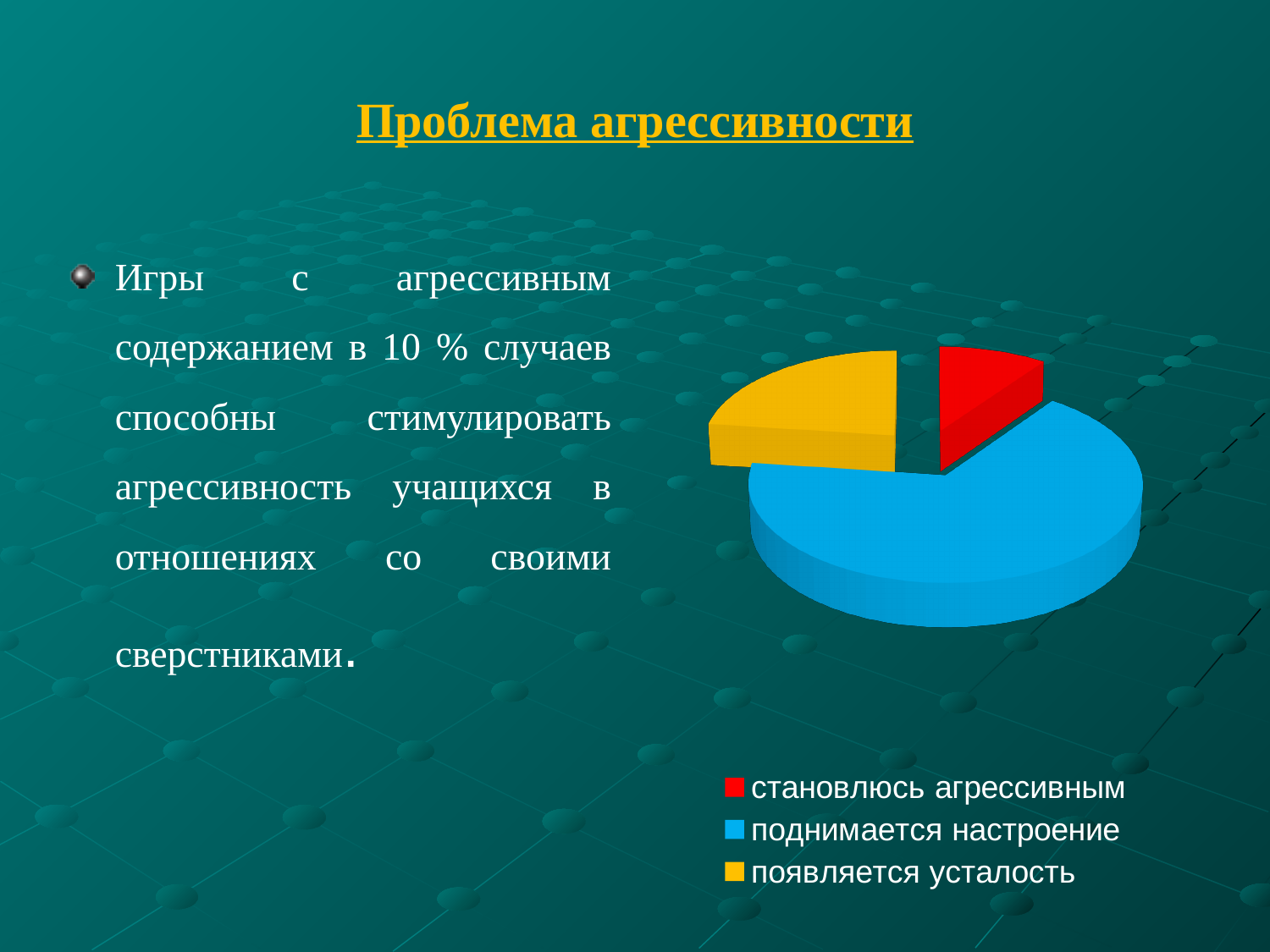
What colour is the slice for "появляется усталость" in the pie chart? yellow Which category has the smallest slice in the pie chart? становлюсь агрессивным How many slices does the pie chart have? 3 Which category is shown in red in the pie chart? становлюсь агрессивным Which slice is larger: "поднимается настроение" or "появляется усталость"? поднимается настроение How many entries does the legend of the pie chart list? 3 Which slice is larger: "появляется усталость" or "становлюсь агрессивным"? появляется усталость Which category has the largest slice in the pie chart? поднимается настроение What kind of chart is shown on the slide? pie chart